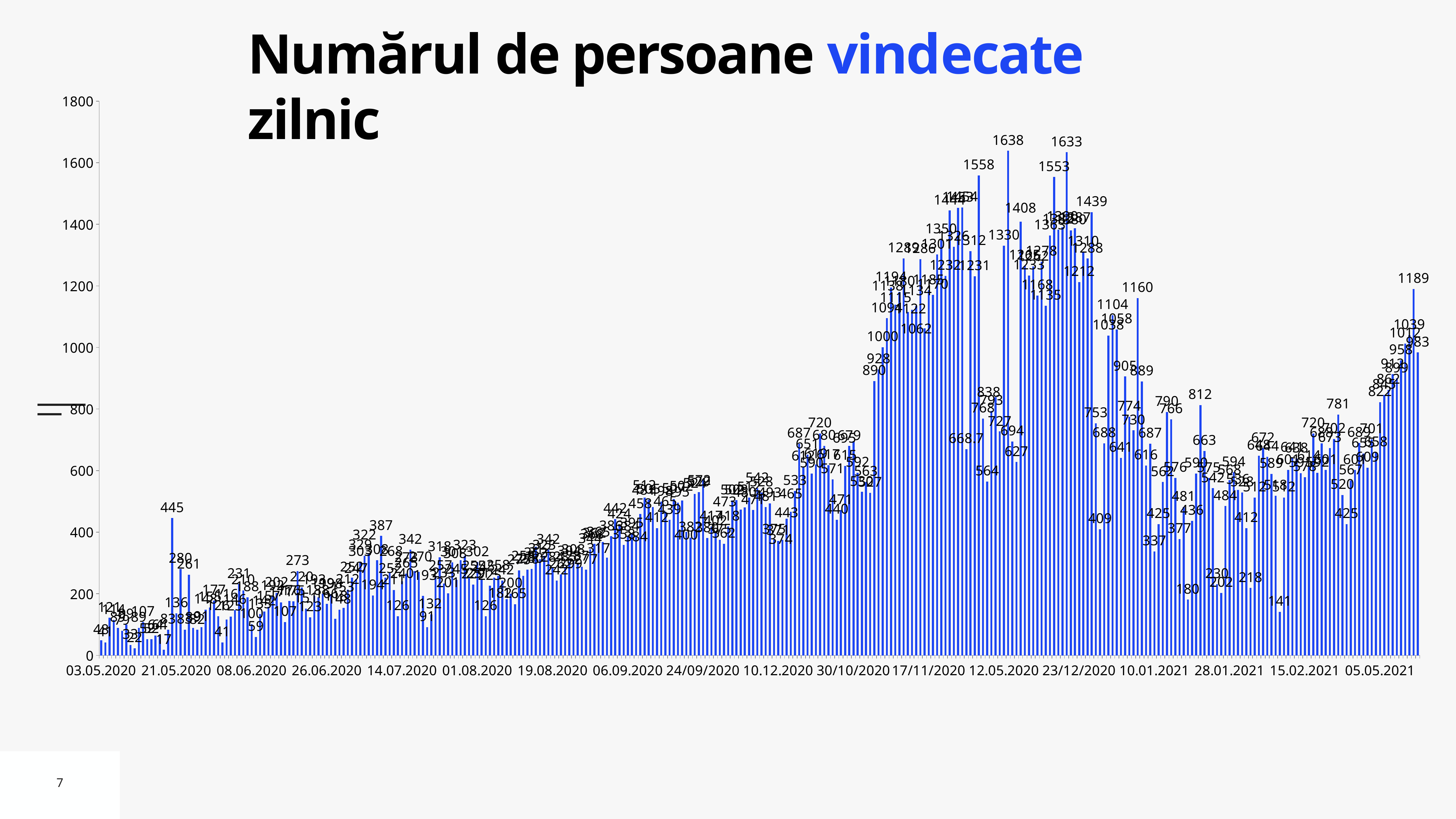
What is the difference between the two highest labeled values, 1638 and 1633? 5 Do the values generally rise or fall from May 2020 to November 2020? rise What is the first date label on the horizontal axis? 03.05.2020 Which is larger: the peak labeled 1638 or the rightmost bar labeled 1189? 1638 What is the value of the last (rightmost) bar on the chart? 983 Is the value of the rightmost bar greater or less than 1000? less What is the highest value shown on the vertical axis? 1800 What kind of chart is shown on the slide? bar chart What is the value of the tallest bar in the May 2020 section of the chart? 445 Is the tallest bar on the chart greater or less than 1600? greater What is the title of the chart? Numărul de persoane vindecate zilnic What is the highest value labeled on the chart? 1638